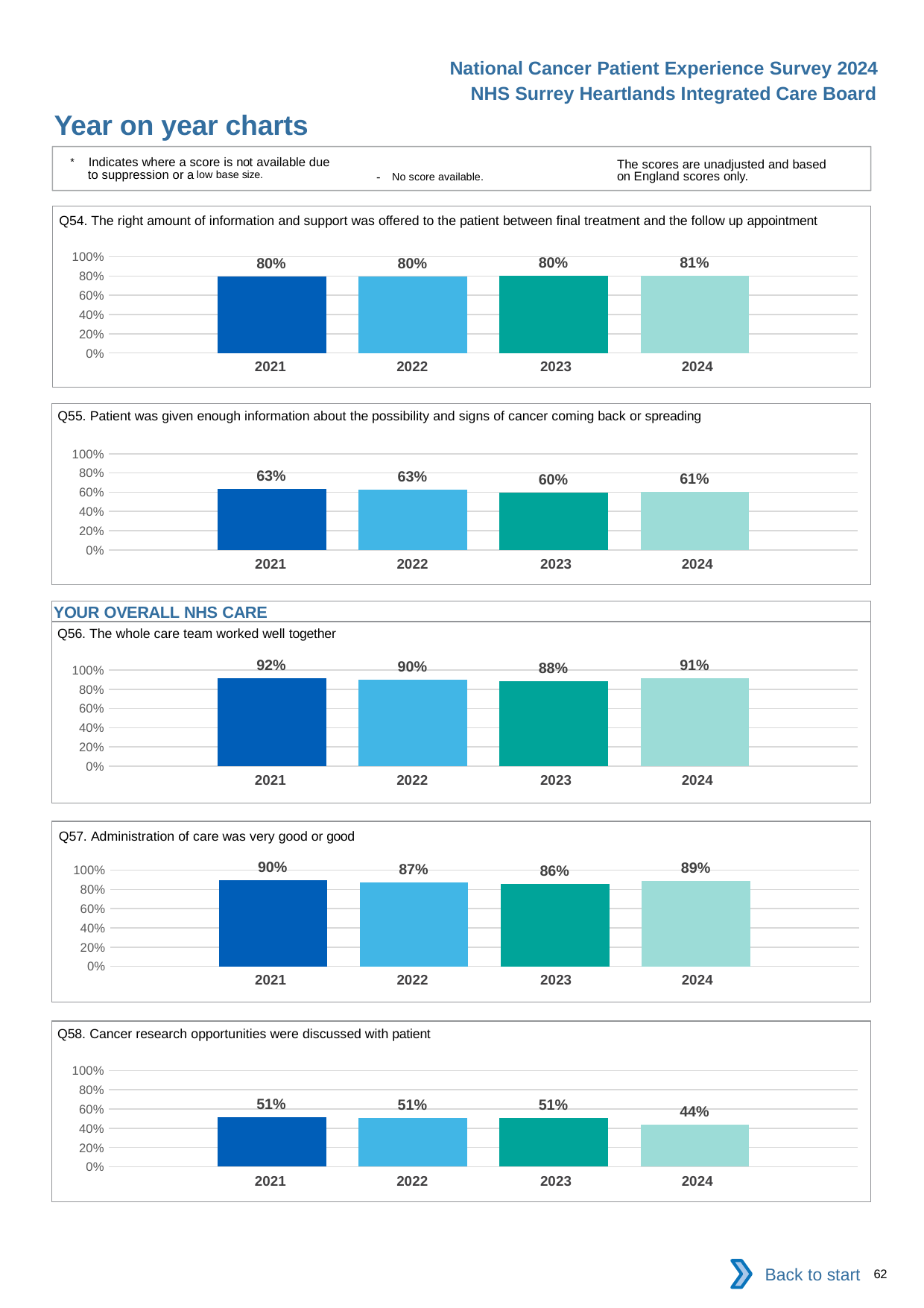
What kind of chart is the Q54 chart? bar chart In the Q54 chart, what is the value for 2024? 81% In the Q58 chart, what is the value for 2024? 44% In the Q58 chart, what is the difference between the 2023 and 2024 values? 7% In the Q58 chart, which is larger, the value for 2023 or the value for 2024? 2023 How many years are shown in the Q57 chart? 4 In the Q55 chart, which year has the lowest value? 2023 In the Q56 chart, which year has the highest value? 2021 In the Q55 chart, is the value for 2022 greater or less than 80%? less In the Q57 chart, what is the difference between the 2021 and 2023 values? 4% What is the title of the chart directly below the heading 'YOUR OVERALL NHS CARE'? Q56. The whole care team worked well together In the Q56 chart, what is the value for 2021? 92%